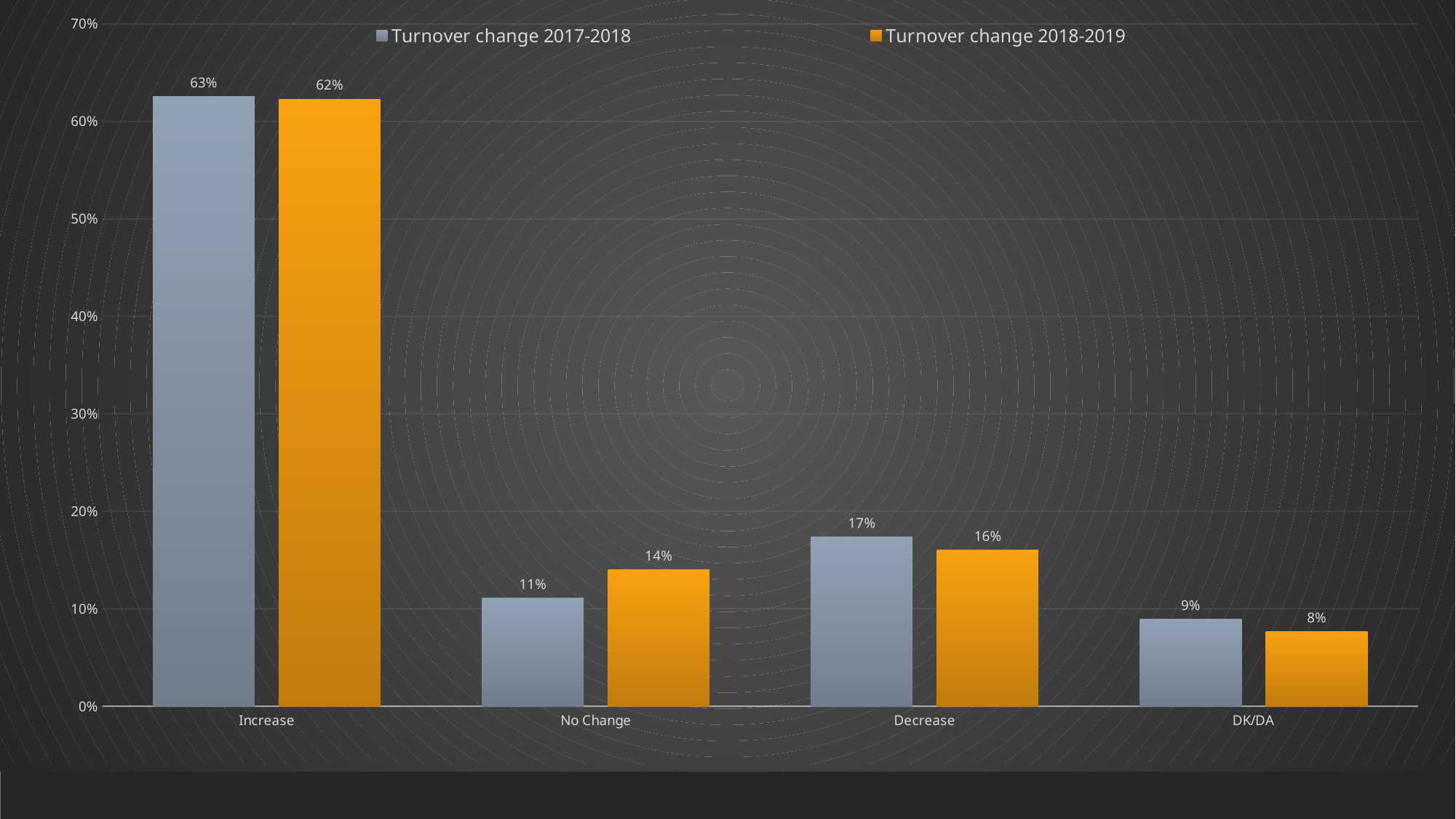
Which category has the highest value in the Turnover change 2018-2019 series? Increase What colour are the bars for the Turnover change 2018-2019 series? orange What is the value for Increase in the Turnover change 2017-2018 series? 63% What kind of chart is shown on the slide? bar chart Which category has the lowest value in the Turnover change 2017-2018 series? DK/DA Is the value for Decrease in the Turnover change 2018-2019 series greater or less than 20%? less What is the difference between the Turnover change 2017-2018 and Turnover change 2018-2019 values for No Change? 3% What is the value for No Change in the Turnover change 2018-2019 series? 14% How many categories are shown on the x axis? 4 For Decrease, which series has the larger value: Turnover change 2017-2018 or Turnover change 2018-2019? Turnover change 2017-2018 How many series does the legend list? 2 What is the value for DK/DA in the Turnover change 2017-2018 series? 9%